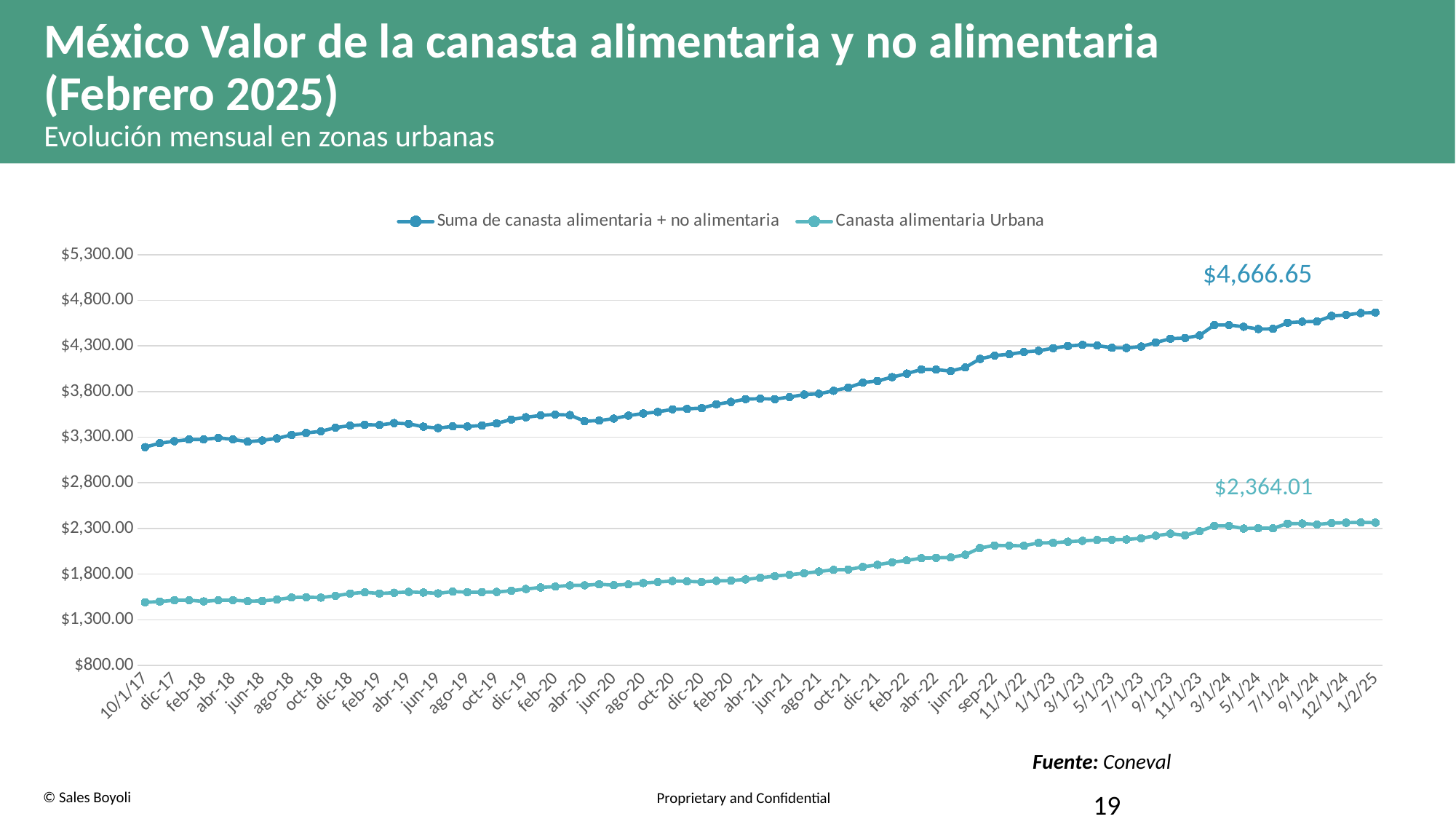
Is the value of 'Suma de canasta alimentaria + no alimentaria' at 10/1/17 greater or less than $3,300.00? less Is the value of 'Canasta alimentaria Urbana' at 10/1/17 greater or less than $1,800.00? less What is the value of the 'Suma de canasta alimentaria + no alimentaria' series at the last point (1/2/25)? $4,666.65 Is the value of 'Suma de canasta alimentaria + no alimentaria' at 1/2/25 greater or less than $4,800.00? less What is the difference between the two labelled values at 1/2/25 ($4,666.65 and $2,364.01)? $2,302.64 What source is cited for the chart data? Coneval Which series reaches the highest value on the chart? Suma de canasta alimentaria + no alimentaria What kind of chart is shown on the slide? Line chart How many series does the legend list? 2 Do the values of 'Canasta alimentaria Urbana' generally rise or fall from 10/1/17 to 1/2/25? Rise Which series has the higher value at 1/2/25, 'Suma de canasta alimentaria + no alimentaria' or 'Canasta alimentaria Urbana'? Suma de canasta alimentaria + no alimentaria What is the value of the 'Canasta alimentaria Urbana' series at the last point (1/2/25)? $2,364.01